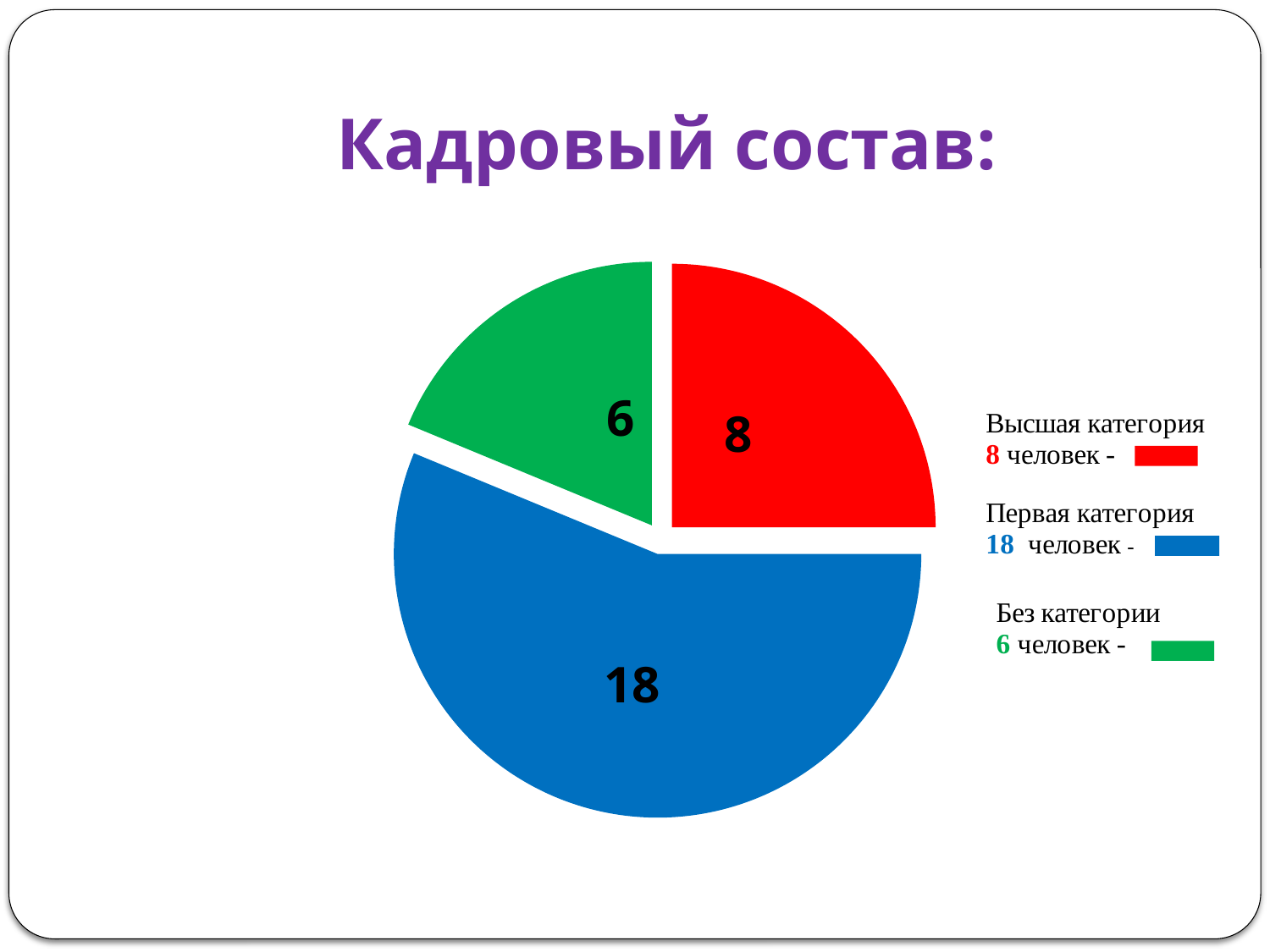
Which colour represents Первая категория in the pie chart? blue What is the difference between the values for Первая категория and Высшая категория? 10 What is the value for Первая категория? 18 Which category has the largest slice of the pie? Первая категория What is the value for Без категории? 6 Which is larger, the value for Высшая категория or the value for Без категории? Высшая категория What type of chart is shown on the slide? pie chart What is the title of the slide with the chart? Кадровый состав: What share of the pie does Высшая категория represent? 25% How many slices does the pie chart have? 3 Which category has the smallest slice of the pie? Без категории What is the value for Высшая категория? 8